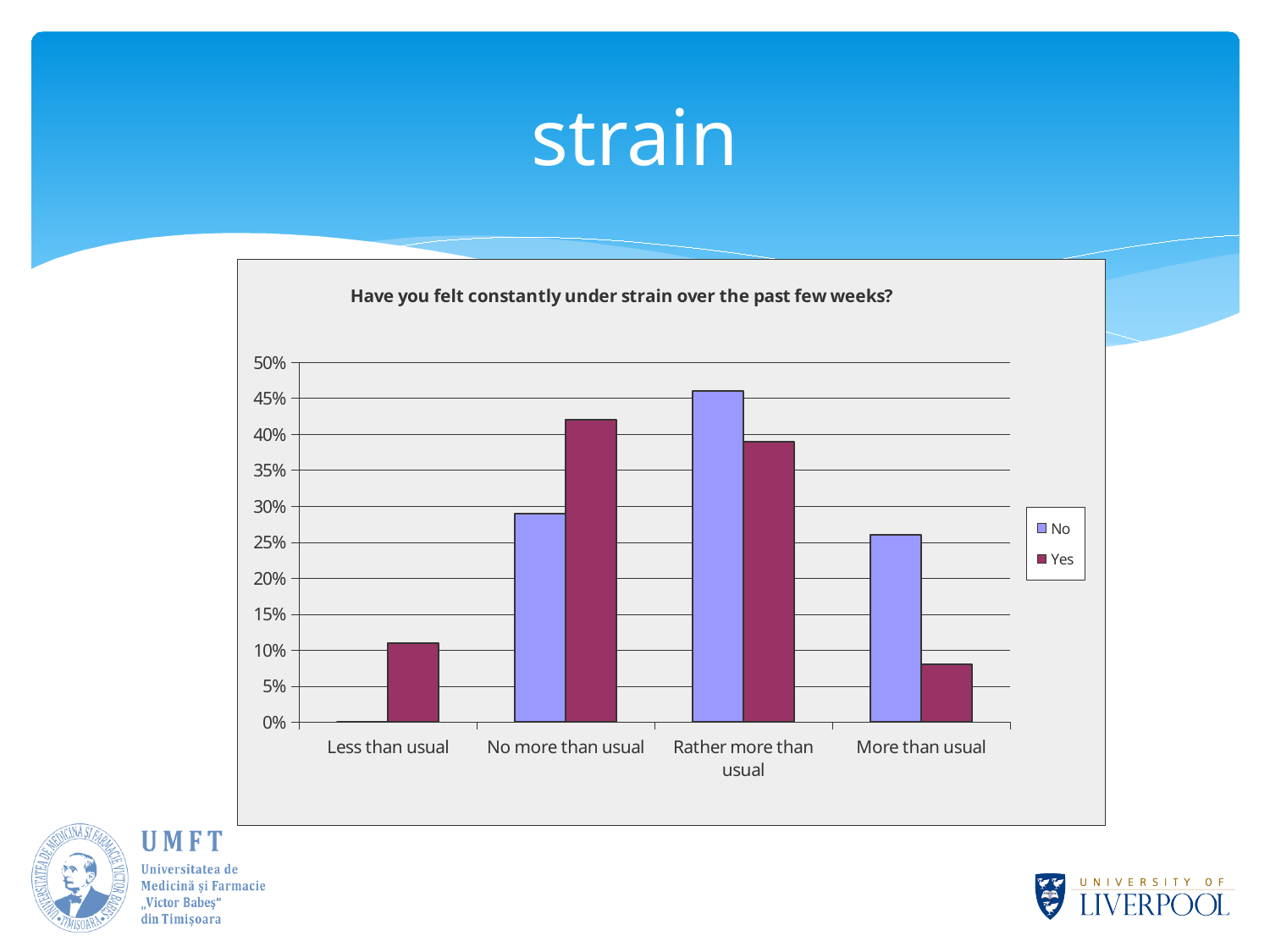
What is the title of the chart? Have you felt constantly under strain over the past few weeks? For the category Rather more than usual, which is larger, No or Yes? No Is the value for Yes at Less than usual greater or less than 15%? less For which category is the Yes bar highest? No more than usual How many categories are shown on the x axis? 4 How many series does the legend list? 2 For which category is the No bar highest? Rather more than usual Which series is shown in purple/red in the legend? Yes For the category No more than usual, which is larger, No or Yes? Yes What kind of chart is shown on the slide? bar chart For which category is the Yes bar lowest? More than usual Is the value for No at Rather more than usual greater or less than 40%? greater